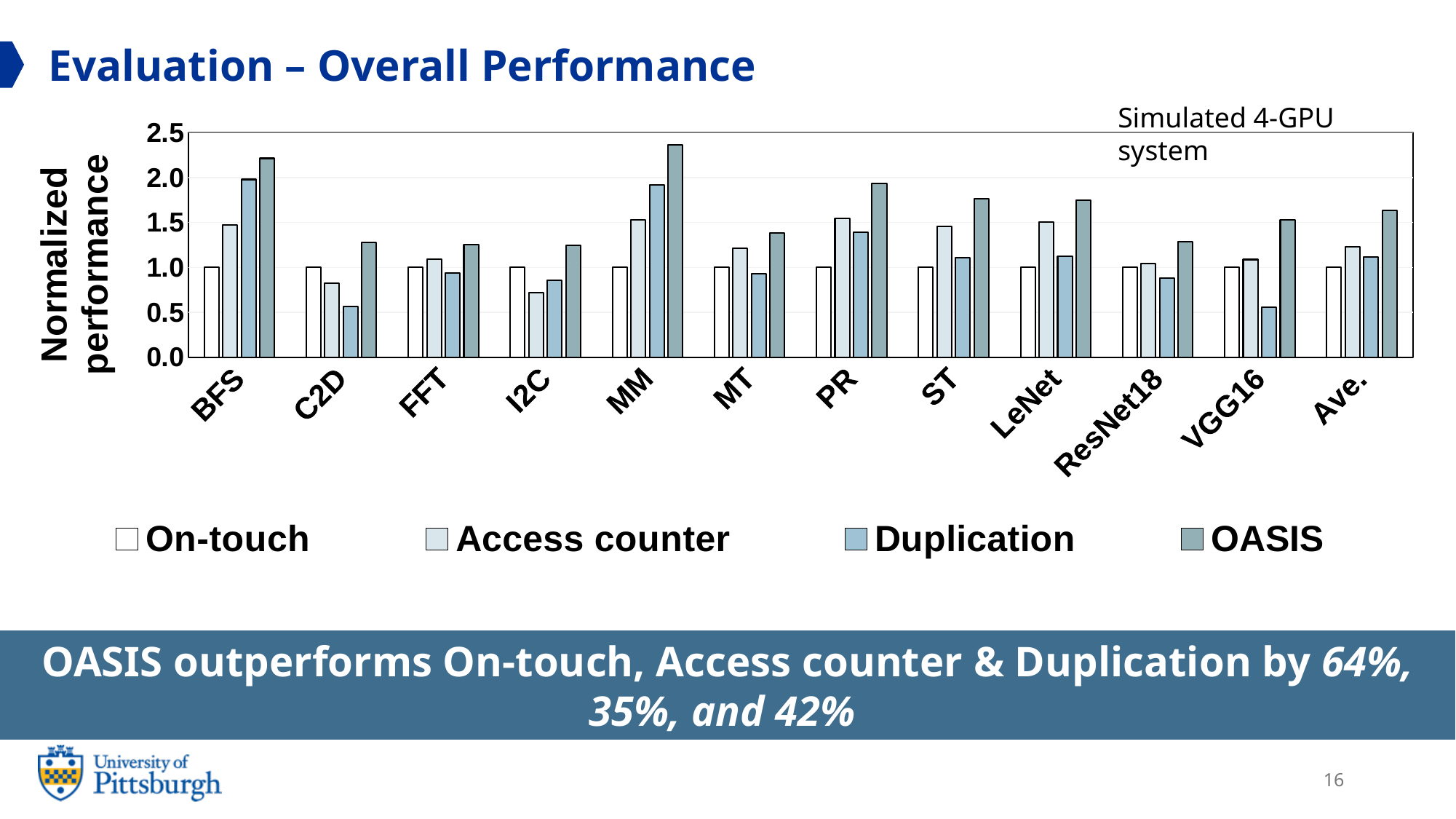
For which benchmark is the OASIS bar the highest? MM What kind of chart is shown on the slide? bar chart How many series does the legend list? 4 For I2C, which is larger: the Access counter value or the Duplication value? Duplication What is the label of the y axis? Normalized performance Is the OASIS value for BFS greater or less than 2.0? greater Is the OASIS value for Ave. greater or less than 1.5? greater What is the normalized performance of On-touch for BFS? 1.0 Is the Duplication value for C2D greater or less than 1.0? less For PR, which is larger: the Access counter value or the OASIS value? OASIS How many benchmark categories are shown along the x axis? 12